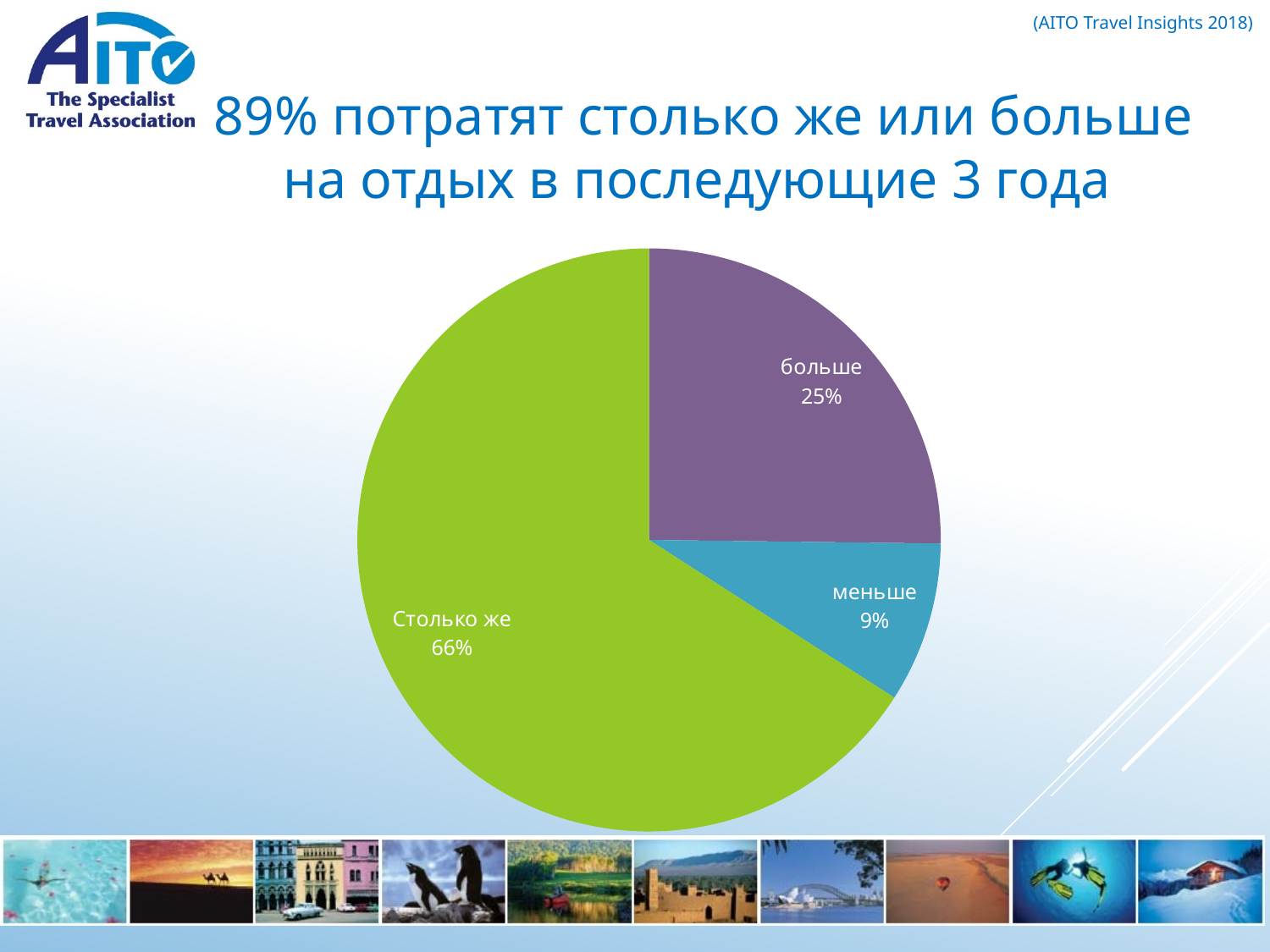
What is the difference in percentage points between the "больше" and "меньше" slices? 16 What share of the pie does the "меньше" slice represent? 9% How many slices does the pie chart have? 3 What colour is the "больше" slice? Purple What share of the pie does the "больше" slice represent? 25% What is the difference in percentage points between the "Столько же" and "больше" slices? 41 What colour is the "Столько же" slice? Green What kind of chart is shown on the slide? Pie chart Which slice of the pie is the largest? Столько же What share of the pie does the "Столько же" slice represent? 66% Which slice of the pie is the smallest? меньше Which slice is larger, "больше" or "меньше"? больше